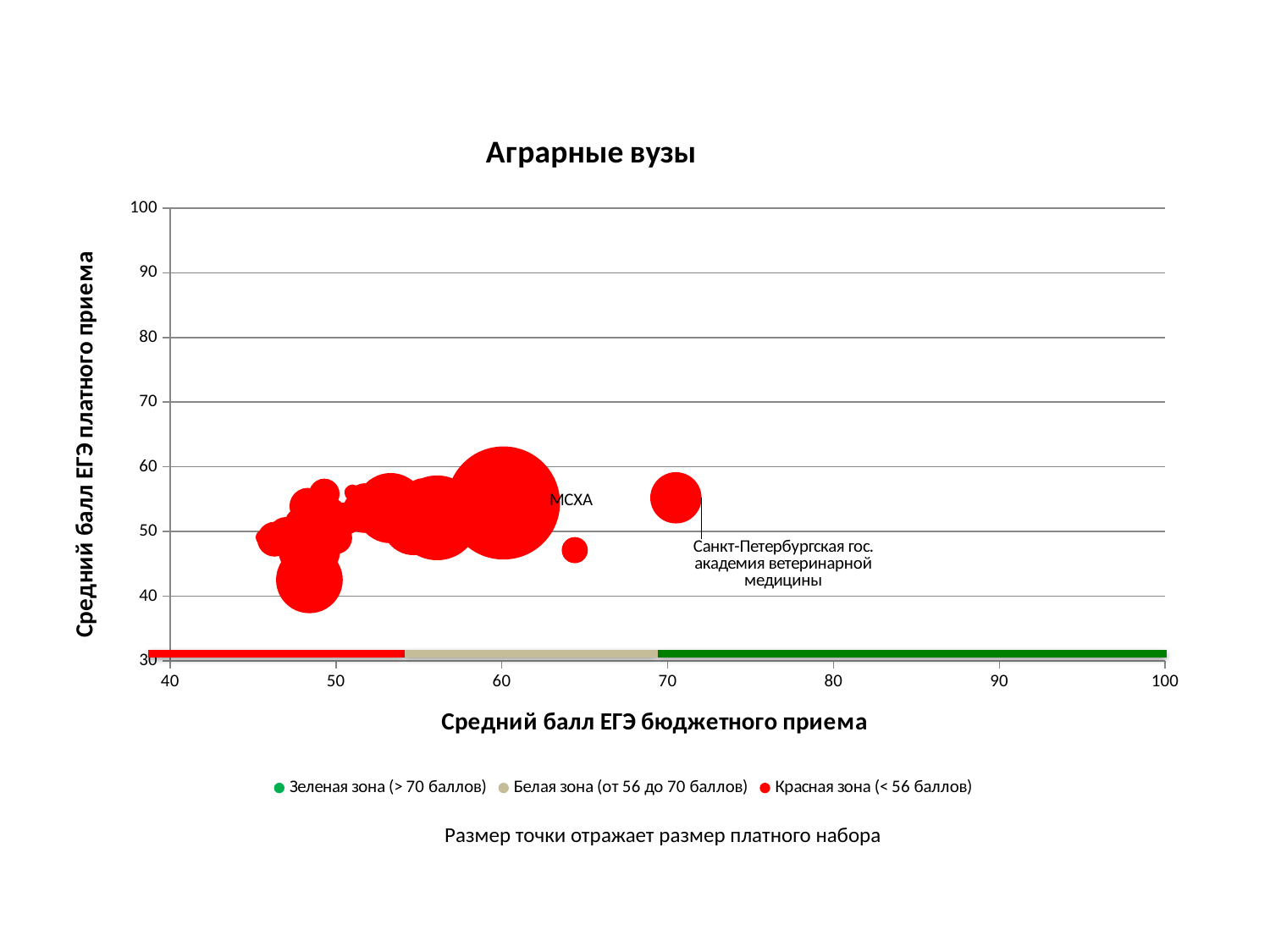
Which legend zone do all the plotted bubbles belong to? Красная зона (< 56 баллов) What is the title of the chart? Аграрные вузы How many entries does the chart legend list? 3 Is the average paid-admission score (y axis) for МСХА greater or less than 70? less Which has the higher average budget-admission score (x axis): МСХА or Санкт-Петербургская гос. академия ветеринарной медицины? Санкт-Петербургская гос. академия ветеринарной медицины What kind of chart is shown on the slide? Bubble chart Is the average budget-admission score (x axis) for МСХА greater or less than 50? greater Is the average paid-admission score (y axis) for Санкт-Петербургская гос. академия ветеринарной медицины greater or less than 50? greater What is the label of the horizontal axis? Средний балл ЕГЭ бюджетного приема